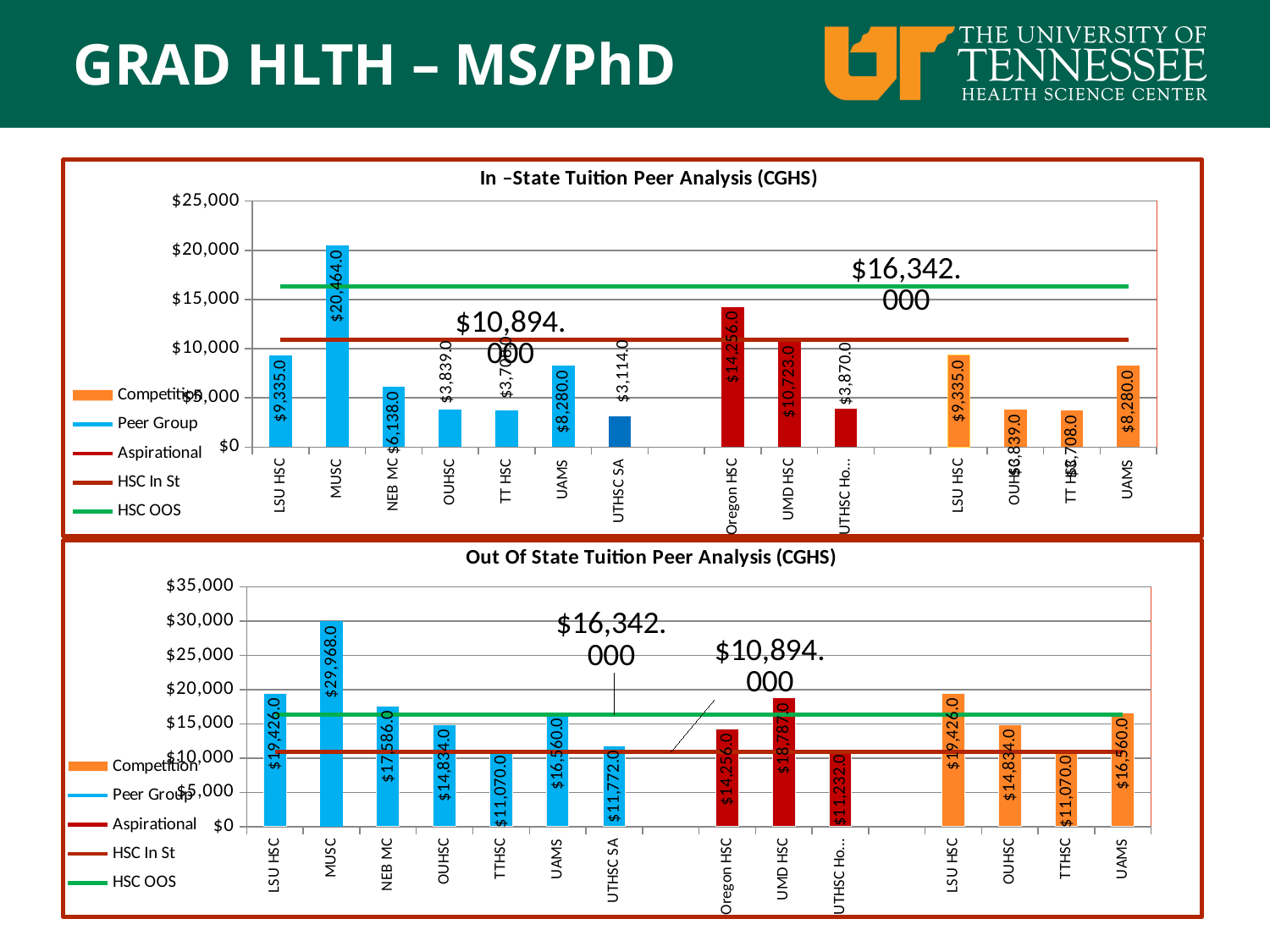
In the In-State Tuition Peer Analysis chart, which is larger, Oregon HSC or UMD HSC? Oregon HSC In the Out Of State Tuition Peer Analysis chart, what is the value for MUSC? $29,968.0 In the In-State Tuition Peer Analysis chart, what is the value for Oregon HSC? $14,256.0 In the Out Of State Tuition Peer Analysis chart, what is the value for UMD HSC? $18,787.0 In the In-State Tuition Peer Analysis chart, what value is shown for the HSC OOS line? $16,342.000 What kind of chart is the In-State Tuition Peer Analysis chart? Bar chart In the In-State Tuition Peer Analysis chart, which institution has the highest tuition? MUSC In the Out Of State Tuition Peer Analysis chart, is the value for NEB MC greater or less than $15,000? greater In the In-State Tuition Peer Analysis chart, what is the value for MUSC? $20,464.0 In the Out Of State Tuition Peer Analysis chart, what is the difference between MUSC and LSU HSC? $10,542.0 How many entries does the legend of the Out Of State Tuition Peer Analysis chart list? 5 In the In-State Tuition Peer Analysis chart, which institution has the lowest tuition? UTHSC SA